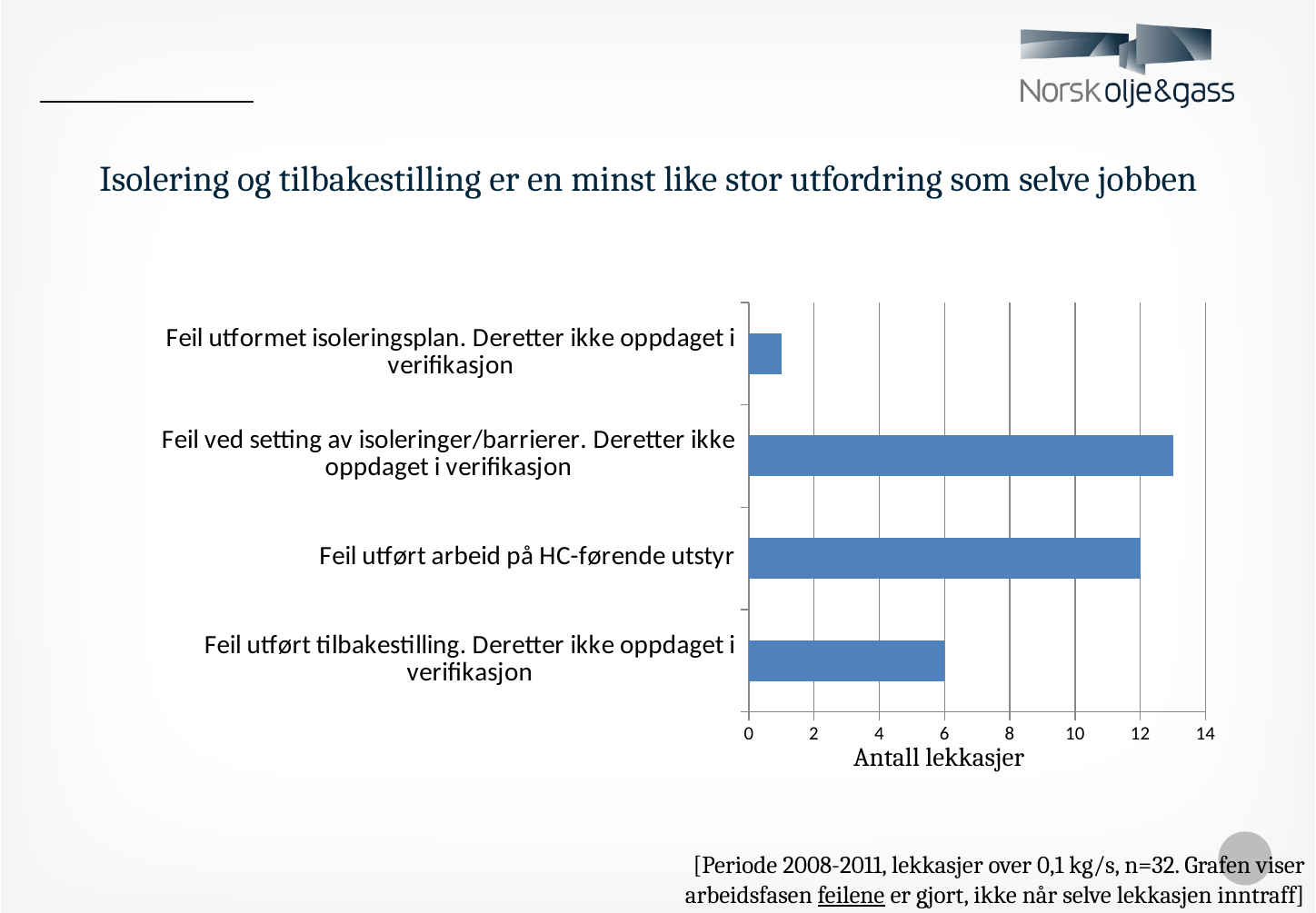
Which category has the highest value? Feil ved setting av isoleringer/barrierer. Deretter ikke oppdaget i verifikasjon What is the value for "Feil utført arbeid på HC-førende utstyr"? 12 How many categories does the chart show? 4 What is the value for "Feil utført tilbakestilling. Deretter ikke oppdaget i verifikasjon"? 6 Is the value for "Feil utformet isoleringsplan. Deretter ikke oppdaget i verifikasjon" greater or less than 2? less What is the label of the horizontal axis? Antall lekkasjer Which category has the lowest value? Feil utformet isoleringsplan. Deretter ikke oppdaget i verifikasjon Is the value for "Feil ved setting av isoleringer/barrierer. Deretter ikke oppdaget i verifikasjon" greater or less than 12? greater Which is larger: the value for "Feil utført arbeid på HC-førende utstyr" or the value for "Feil utført tilbakestilling. Deretter ikke oppdaget i verifikasjon"? Feil utført arbeid på HC-førende utstyr What kind of chart is shown on the slide? bar chart What is the difference between the values for "Feil utført arbeid på HC-førende utstyr" and "Feil utført tilbakestilling. Deretter ikke oppdaget i verifikasjon"? 6 What is the maximum value shown on the horizontal axis? 14